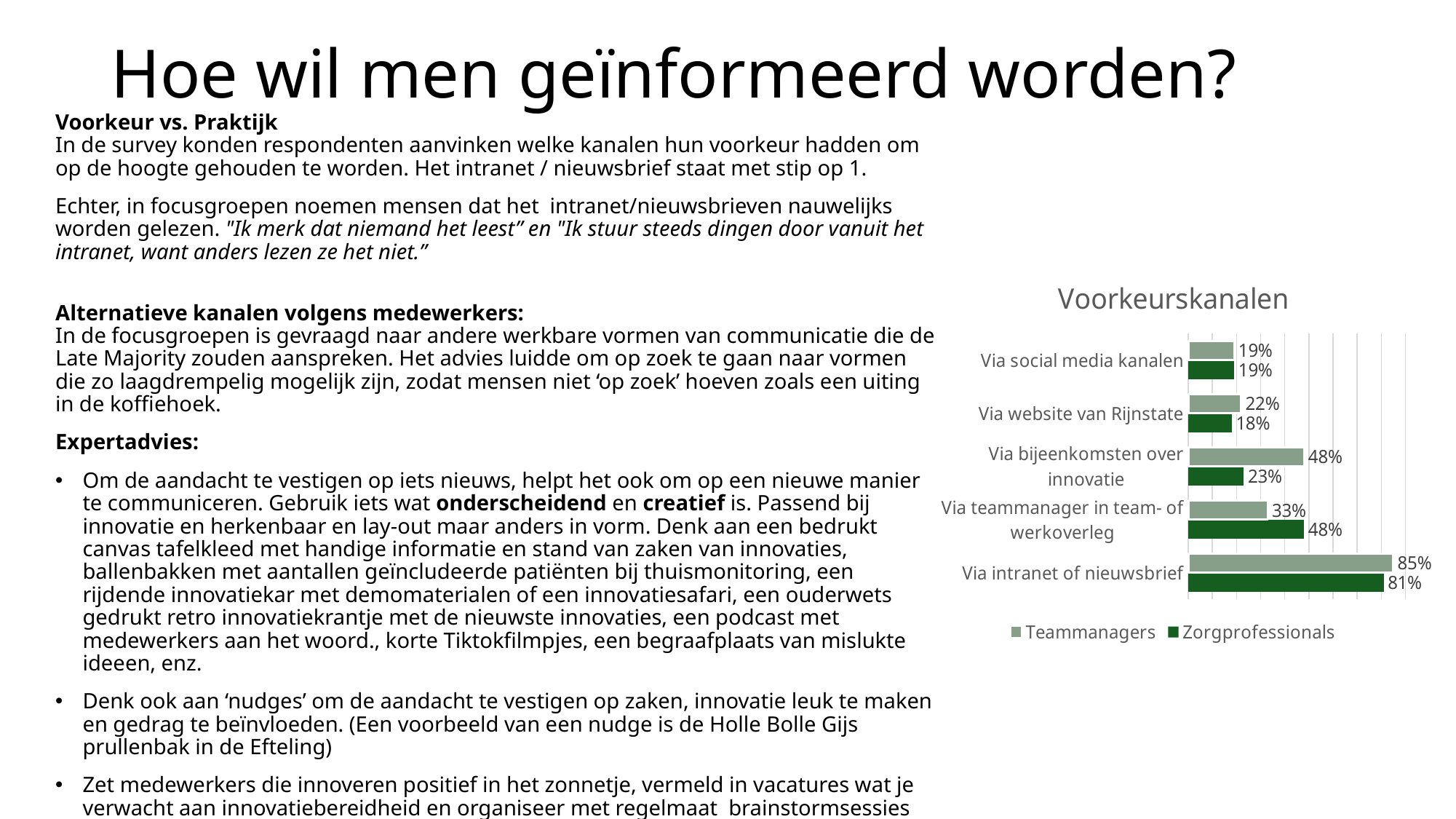
What is the value for Zorgprofessionals for 'Via website van Rijnstate'? 18% What kind of chart is shown on the slide? bar chart For 'Via teammanager in team- of werkoverleg', which series has the larger value, Teammanagers or Zorgprofessionals? Zorgprofessionals Which category has the lowest value for Teammanagers? Via social media kanalen How many series does the legend list? 2 What is the value for Zorgprofessionals for 'Via bijeenkomsten over innovatie'? 23% How many categories are shown in the chart? 5 What is the title of the chart? Voorkeurskanalen Which category has the highest value for Zorgprofessionals? Via intranet of nieuwsbrief What is the difference between Teammanagers and Zorgprofessionals for 'Via bijeenkomsten over innovatie'? 25% What is the value for Teammanagers for 'Via intranet of nieuwsbrief'? 85% What are the two series listed in the legend? Teammanagers and Zorgprofessionals